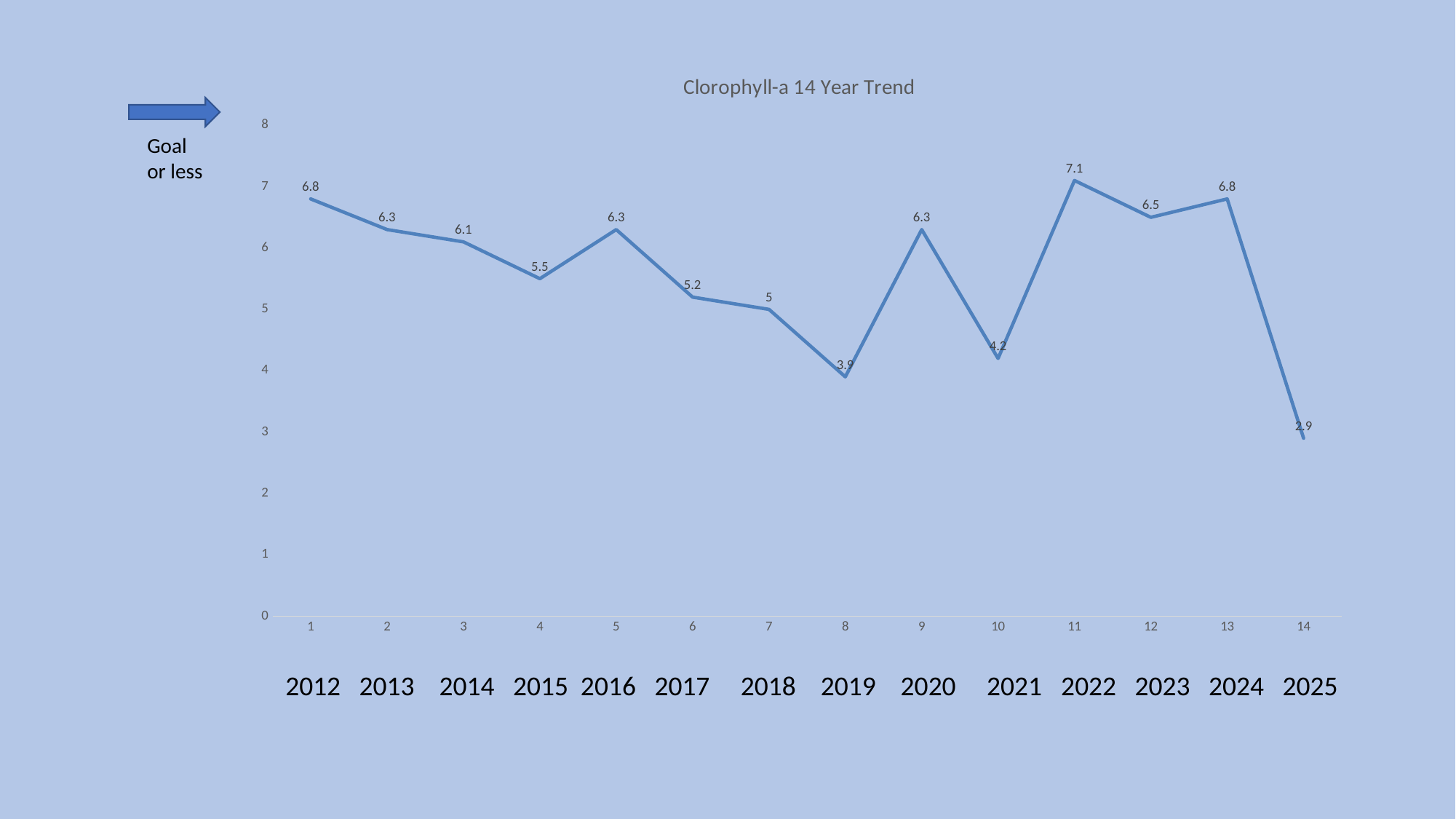
Which is larger, the value at point 4 (2015) or the value at point 5 (2016)? point 5 (2016) How many data points are plotted on the line? 14 What is the value for point 8 (2019)? 3.9 Which point has the lowest value? 14 (2025) What is the value for point 1 (2012)? 6.8 What is the value for point 14 (2025)? 2.9 What is the value for point 12 (2023)? 6.5 Which point has the highest value? 11 (2022) Is the value for point 10 (2021) greater or less than 5? less What is the difference between the value at point 11 (2022) and the value at point 14 (2025)? 4.2 What is the title of the chart? Clorophyll-a 14 Year Trend What kind of chart is shown on the slide? line chart